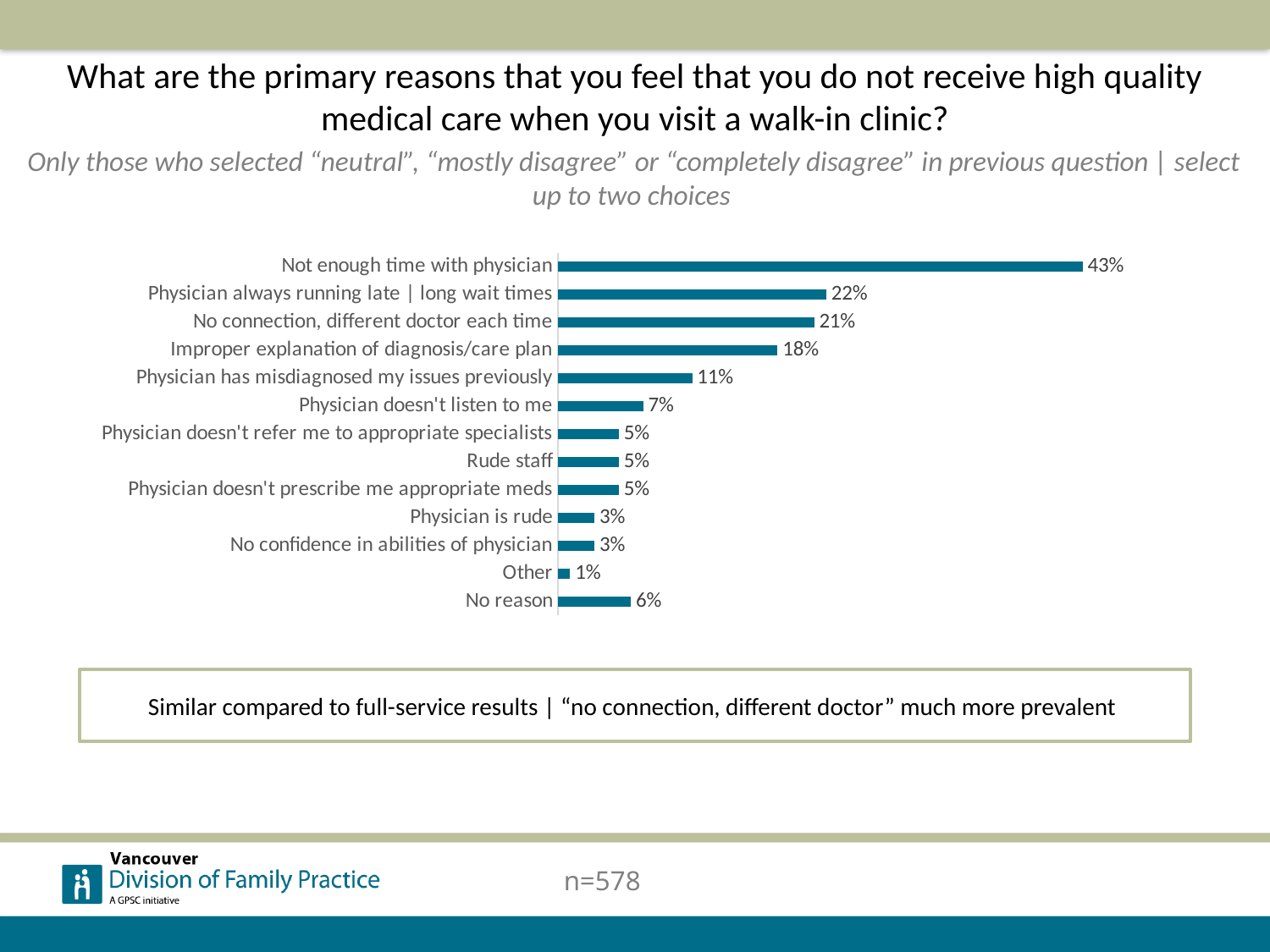
How many categories are shown in the chart? 13 What percentage of respondents selected "Not enough time with physician"? 43% What kind of chart is shown on the slide? Bar chart What is the value for "No connection, different doctor each time"? 21% What is the value for "No reason"? 6% What is the sample size (n) shown on the slide? n=578 What percentage selected "Physician has misdiagnosed my issues previously"? 11% How many categories have a value of 5%? 3 What is the difference between "Not enough time with physician" and "Physician always running late | long wait times"? 21 percentage points Which category has the lowest percentage? Other Which is larger: "Improper explanation of diagnosis/care plan" or "Physician doesn't listen to me"? Improper explanation of diagnosis/care plan Which reason has the highest percentage? Not enough time with physician